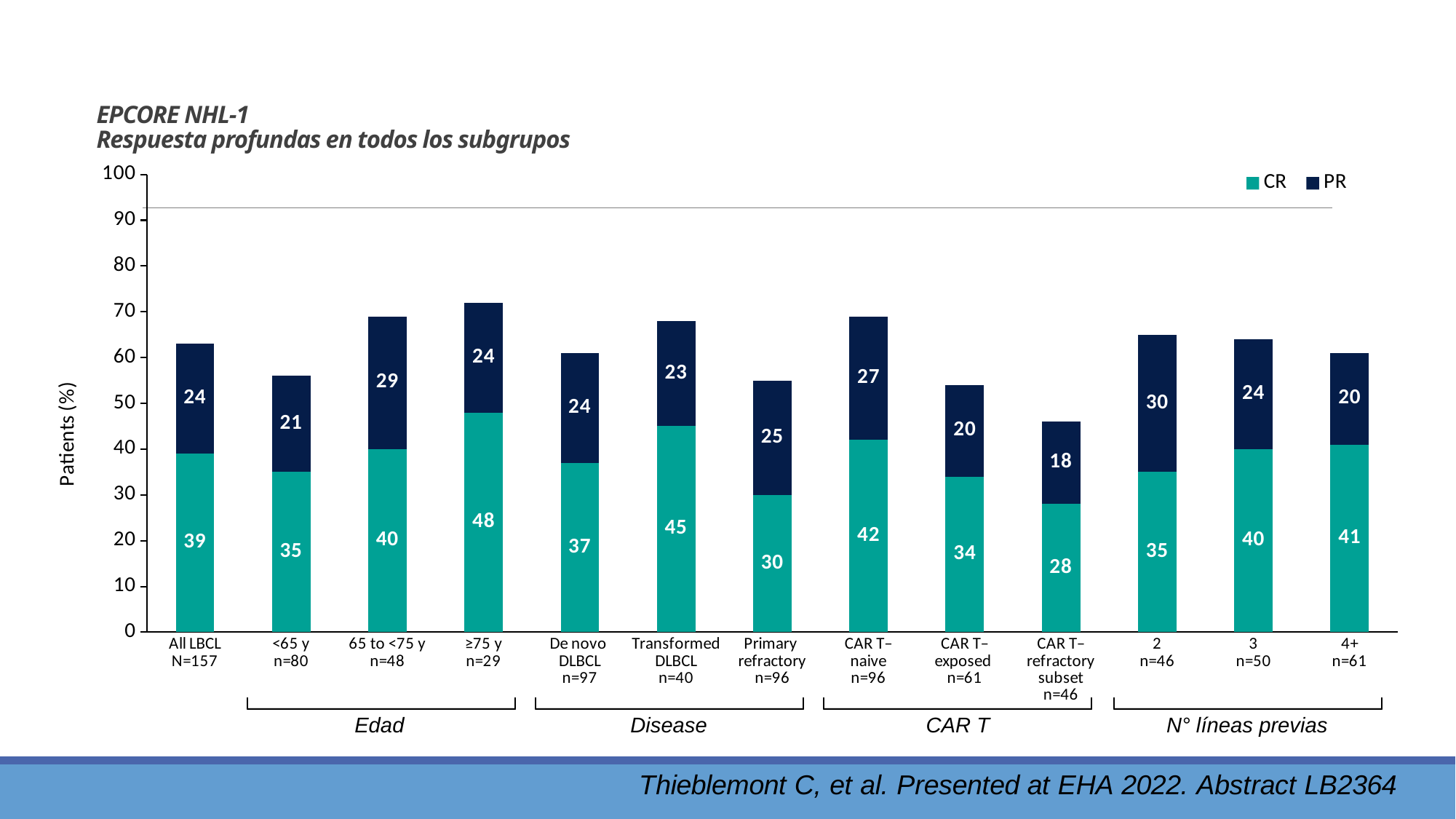
What is the CR value for the All LBCL group? 39 Which subgroup has the highest CR value? ≥75 y Which subgroup has the lowest CR value? CAR T–refractory subset What is the difference between the CR values of Transformed DLBCL and De novo DLBCL? 8 Which is larger, the CR value for CAR T–naive or for CAR T–exposed? CAR T–naive What kind of chart is shown on the slide? Stacked bar chart How many subgroups (bars) are shown on the chart? 13 What is the total stacked value (CR plus PR) for the ≥75 y group? 72 How many series does the legend list? 2 What is the PR value for the Primary refractory group? 25 What is the total stacked value (CR plus PR) for the CAR T–refractory subset? 46 Which subgroup has the highest PR value? 2 (n=46)